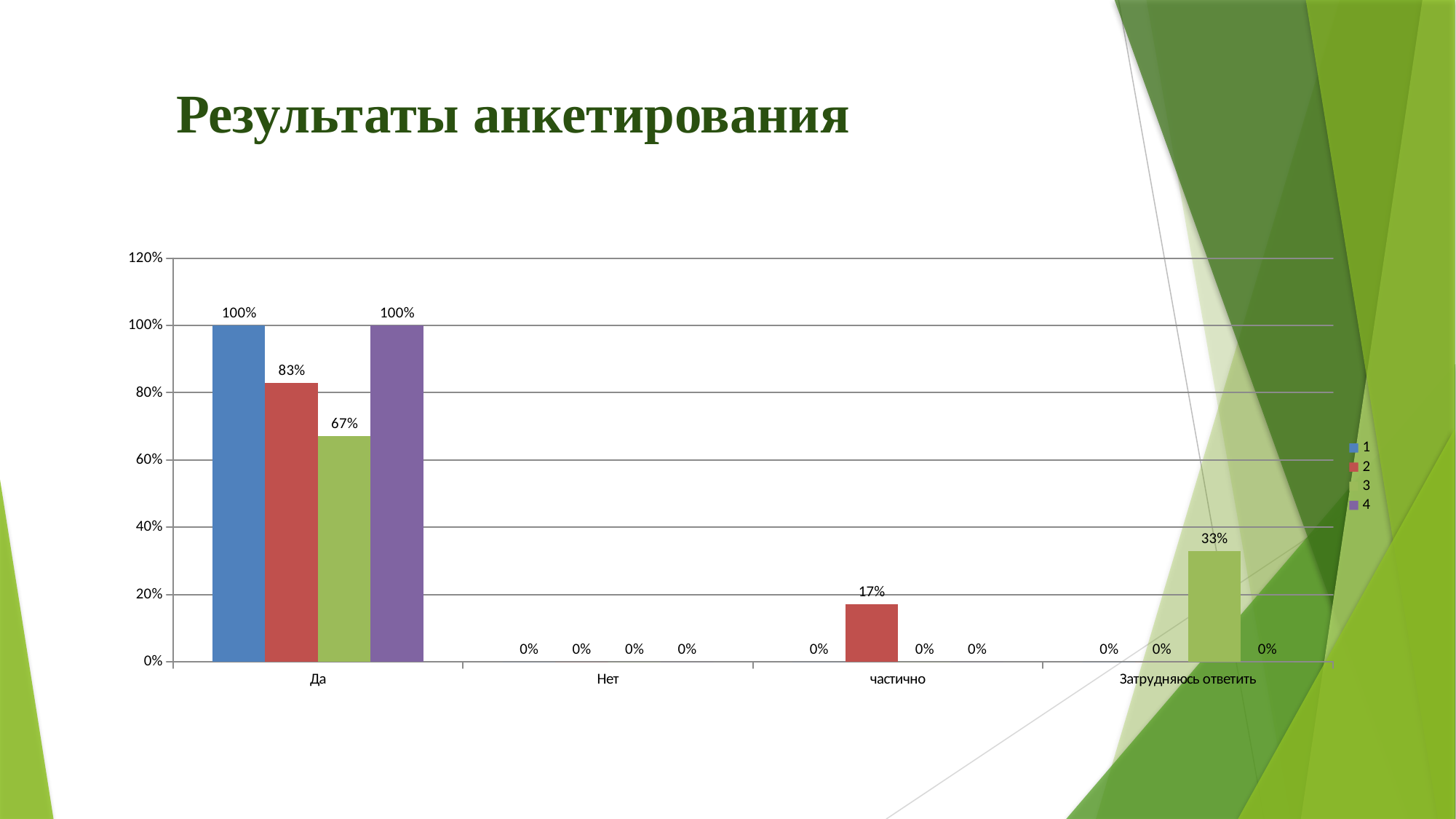
What is the value for series 3 in the category "Да"? 67% What is the difference between series 1 and series 3 in the category "Да"? 33% What is the title of the slide? Результаты анкетирования What is the value for series 2 in the category "Да"? 83% What is the value for series 2 in the category "частично"? 17% Which is larger: series 2 in "частично" or series 3 in "Затрудняюсь ответить"? series 3 in "Затрудняюсь ответить" Which series has the lowest value in the category "Да"? 3 How many series does the legend list? 4 How many categories are shown on the x axis? 4 What is the value for series 3 in the category "Затрудняюсь ответить"? 33% What type of chart is shown on the slide? bar chart What is the value for series 4 in the category "Нет"? 0%